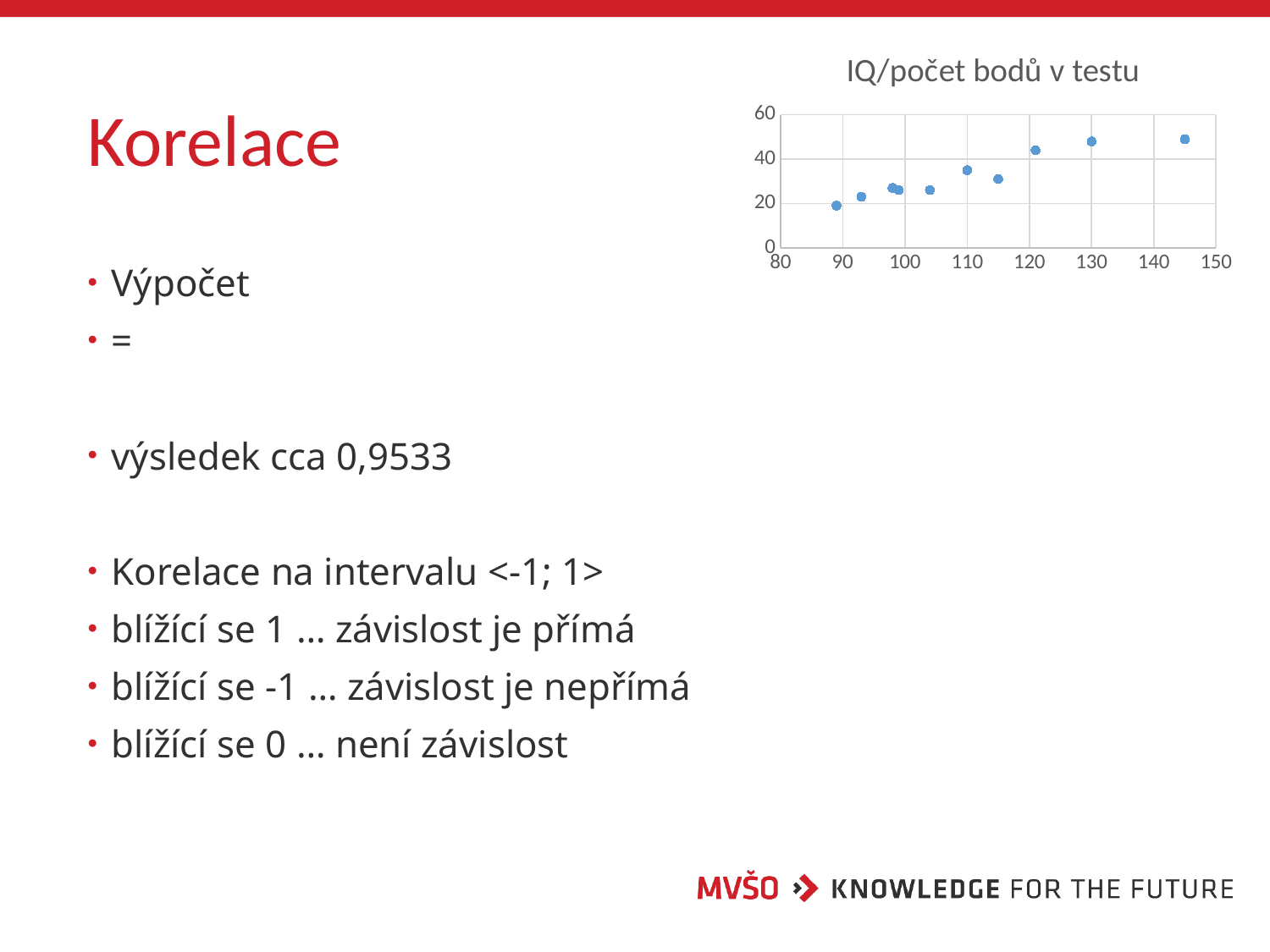
What kind of chart is shown on the slide? scatter chart Is the value for the point at x ≈ 93 greater or less than 40? less Which point has the lowest y value: the one at x ≈ 89 or the one at x ≈ 130? the one at x ≈ 89 What is the maximum value shown on the vertical axis? 60 Which point has the higher y value: the one at x ≈ 110 or the one at x ≈ 115? the one at x ≈ 110 What is the title of the chart? IQ/počet bodů v testu Is the value for the point at x ≈ 121 greater or less than 40? greater Is the value for the point at x ≈ 110 greater or less than 20? greater Do the plotted values generally rise or fall as the x-axis value increases? rise